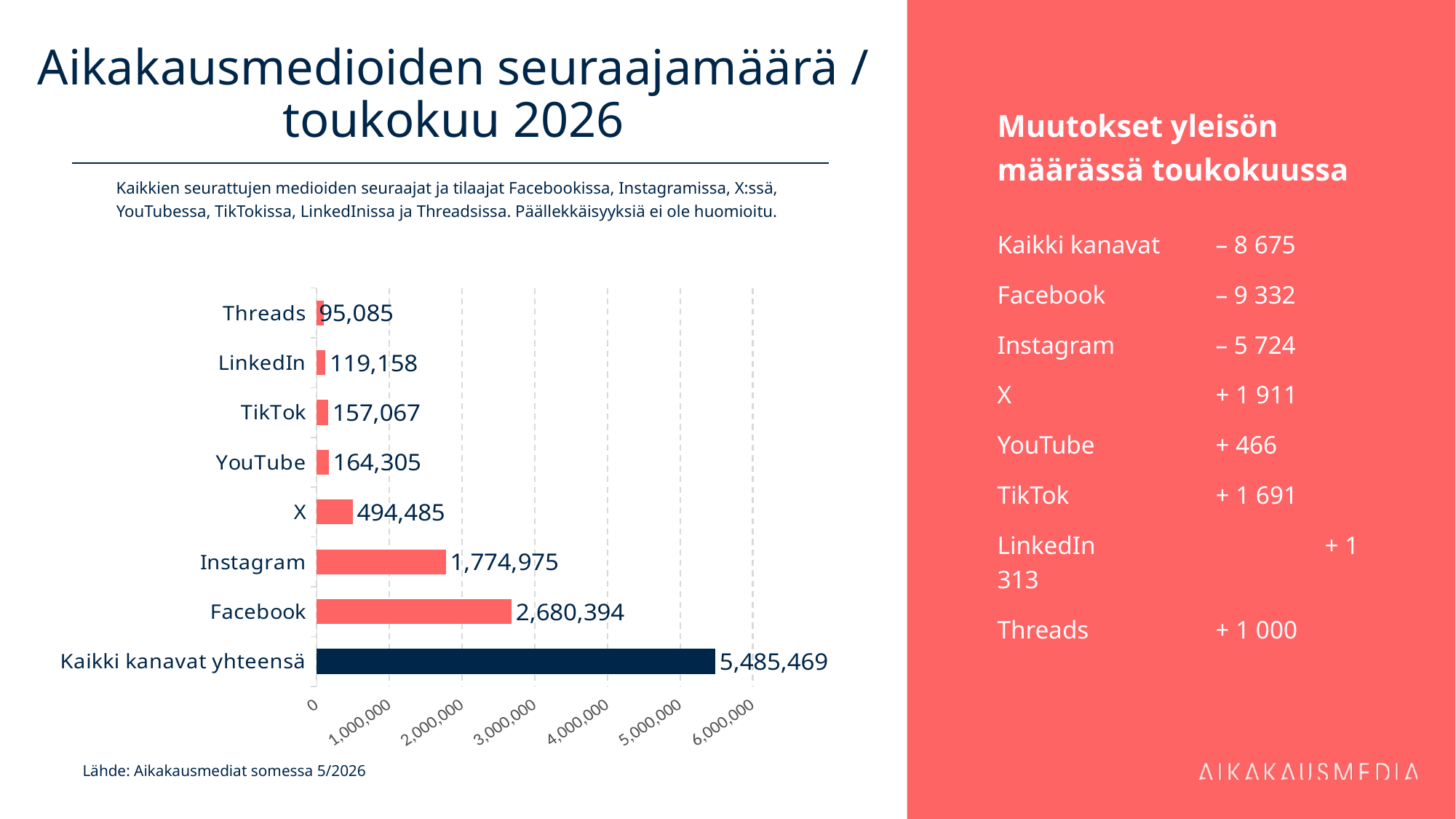
Which category has the lowest value in the chart? Threads What is the value shown for Threads? 95,085 What is the value shown for Instagram? 1,774,975 What is the value shown for the bar labelled 'Kaikki kanavat yhteensä'? 5,485,469 What is the value shown for Facebook? 2,680,394 Which has a larger value, TikTok or LinkedIn? TikTok Excluding the 'Kaikki kanavat yhteensä' total bar, which platform has the highest value? Facebook What is the difference between the values for X and YouTube? 330,180 Is the value for Instagram greater or less than 2,000,000? less What is the difference between the values for Facebook and Instagram? 905,419 What type of chart is shown on the slide? Bar chart How many bars are shown in the chart? 8